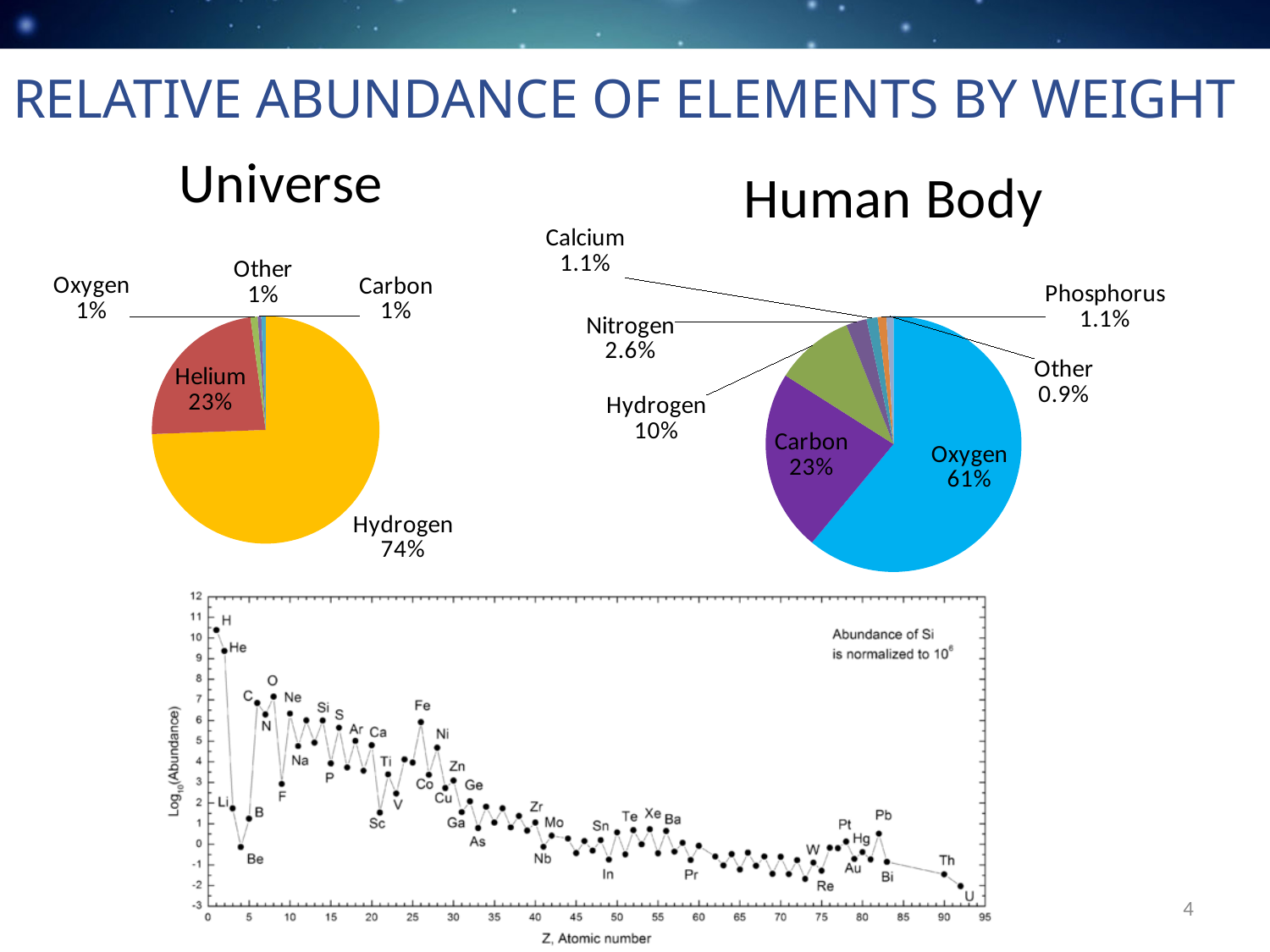
In the bottom chart, what is the label of the x axis? Z, Atomic number In the Human Body pie chart, which element has the largest share? Oxygen In the Human Body pie chart, what is the difference between the Oxygen and Carbon shares? 38% In the Universe pie chart, what percentage is Helium? 23% Which is larger: the Hydrogen share in the Universe pie chart or the Hydrogen share in the Human Body pie chart? Universe In the bottom chart of abundance versus atomic number, is the value for H greater or less than 10? greater In the Human Body pie chart, what percentage is Nitrogen? 2.6% In the Universe pie chart, how many slices are there? 5 In the Human Body pie chart, what percentage is Oxygen? 61% In the Human Body pie chart, how many slices are there? 7 In the Human Body pie chart, which slice has the smallest share? Other In the Universe pie chart, what percentage is Hydrogen? 74%